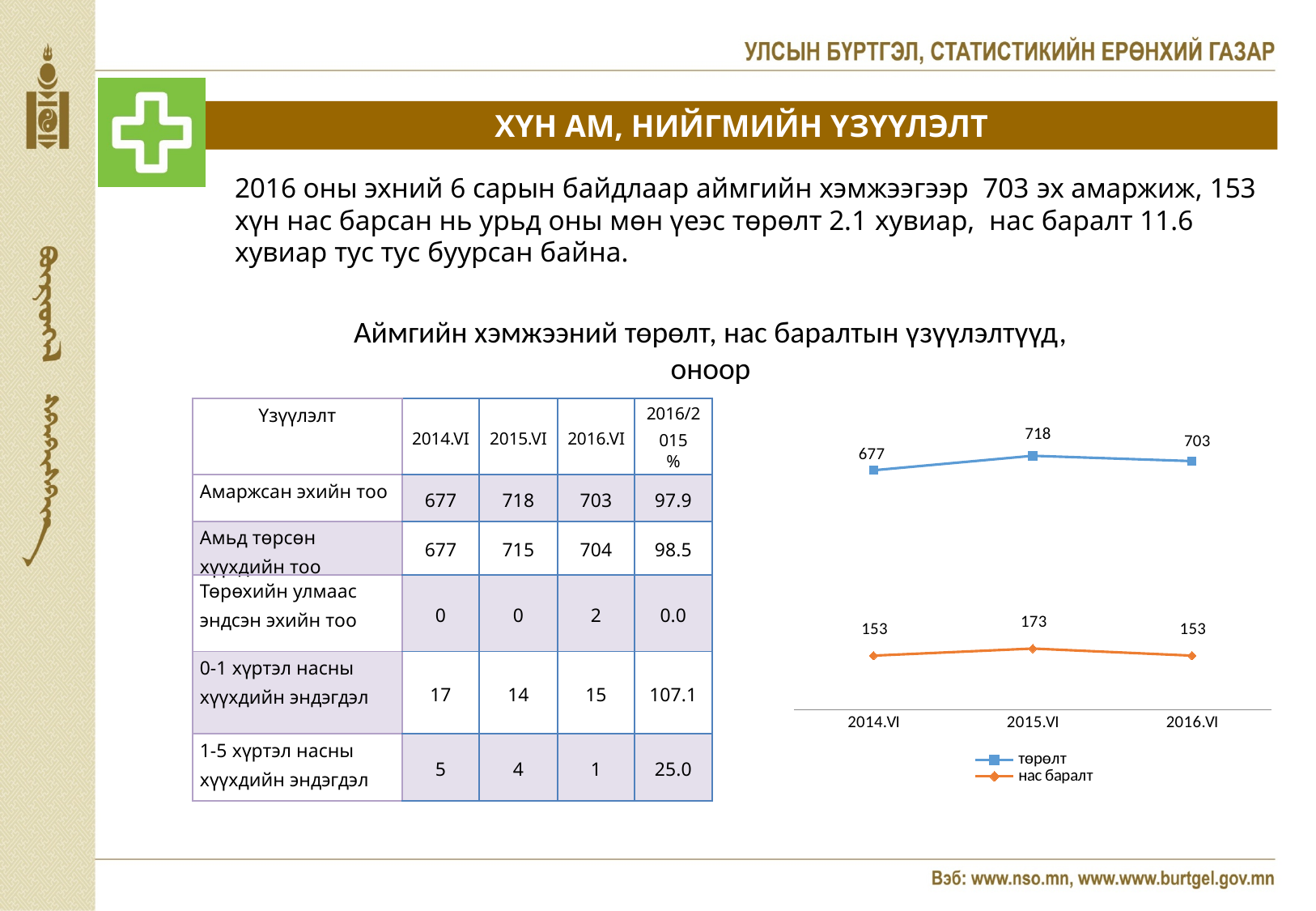
What is the value of төрөлт for 2014.VI in the chart? 677 What is the difference between төрөлт in 2015.VI and 2016.VI in the chart? 15 What is the difference between нас баралт in 2015.VI and 2014.VI in the chart? 20 What is the value of нас баралт for 2016.VI in the chart? 153 In which period is төрөлт lowest in the chart? 2014.VI Which is larger in the chart for 2016.VI: төрөлт or нас баралт? төрөлт What is the value of төрөлт for 2015.VI in the chart? 718 How many series does the chart legend list? 2 Which series in the chart is drawn in orange? нас баралт In which period is төрөлт highest in the chart? 2015.VI What type of chart is shown on the slide? line chart How many points are plotted along the x axis for each series in the chart? 3